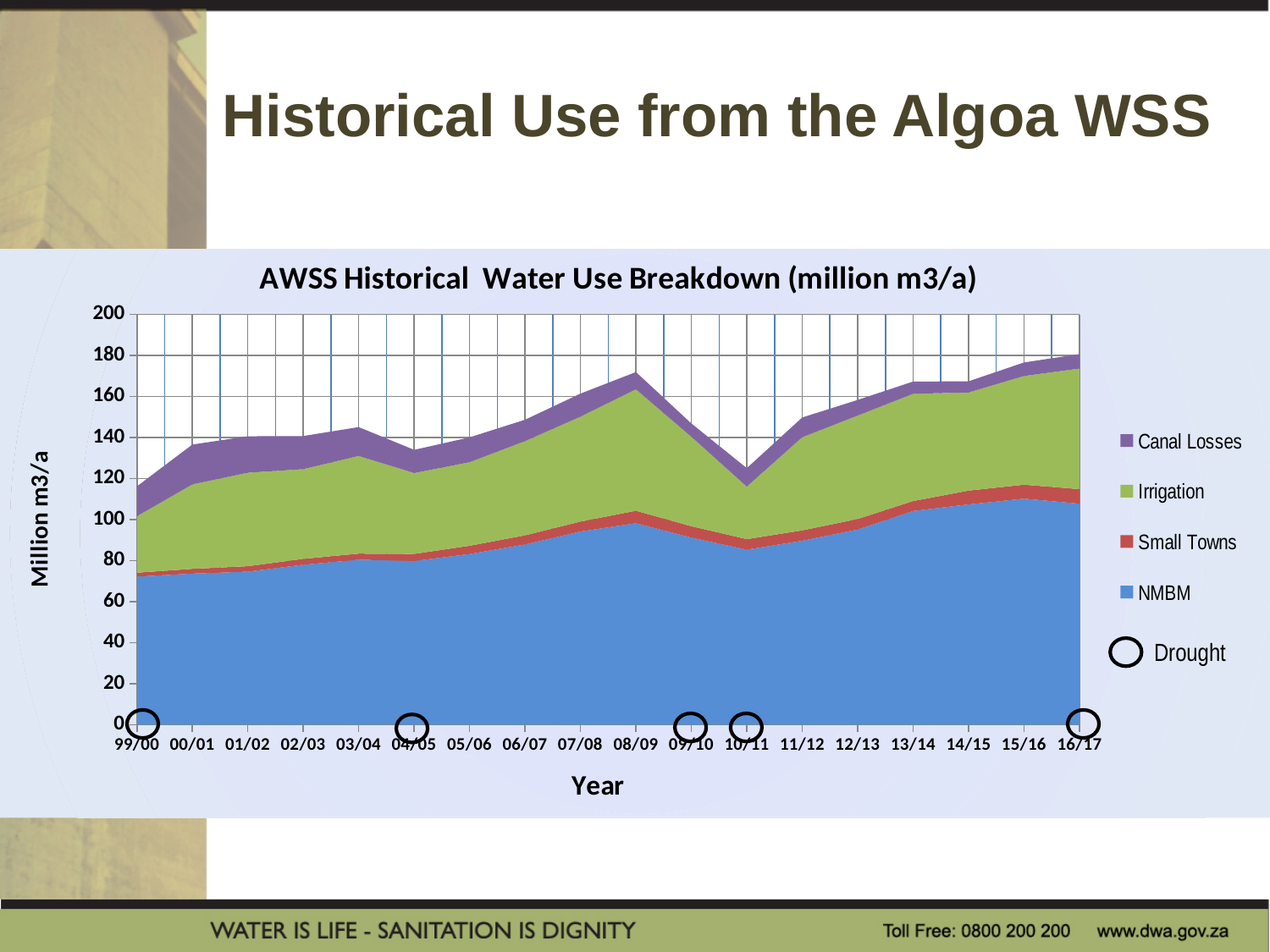
Which is larger, the total water use in 08/09 or in 10/11? 08/09 Does the total water use generally rise or fall from 99/00 to 16/17? rise Is the total water use for 08/09 greater or less than 160? greater What kind of chart is shown on the slide? Stacked area chart How many years are shown along the x axis of the chart? 18 What is the title of the chart? AWSS Historical Water Use Breakdown (million m3/a) Which series is shown in blue at the bottom of the stack? NMBM Is the total water use for 99/00 greater or less than 100? greater Is the total water use for 13/14 greater or less than 140? greater How many stacked data series (coloured areas) does the chart's legend list? 4